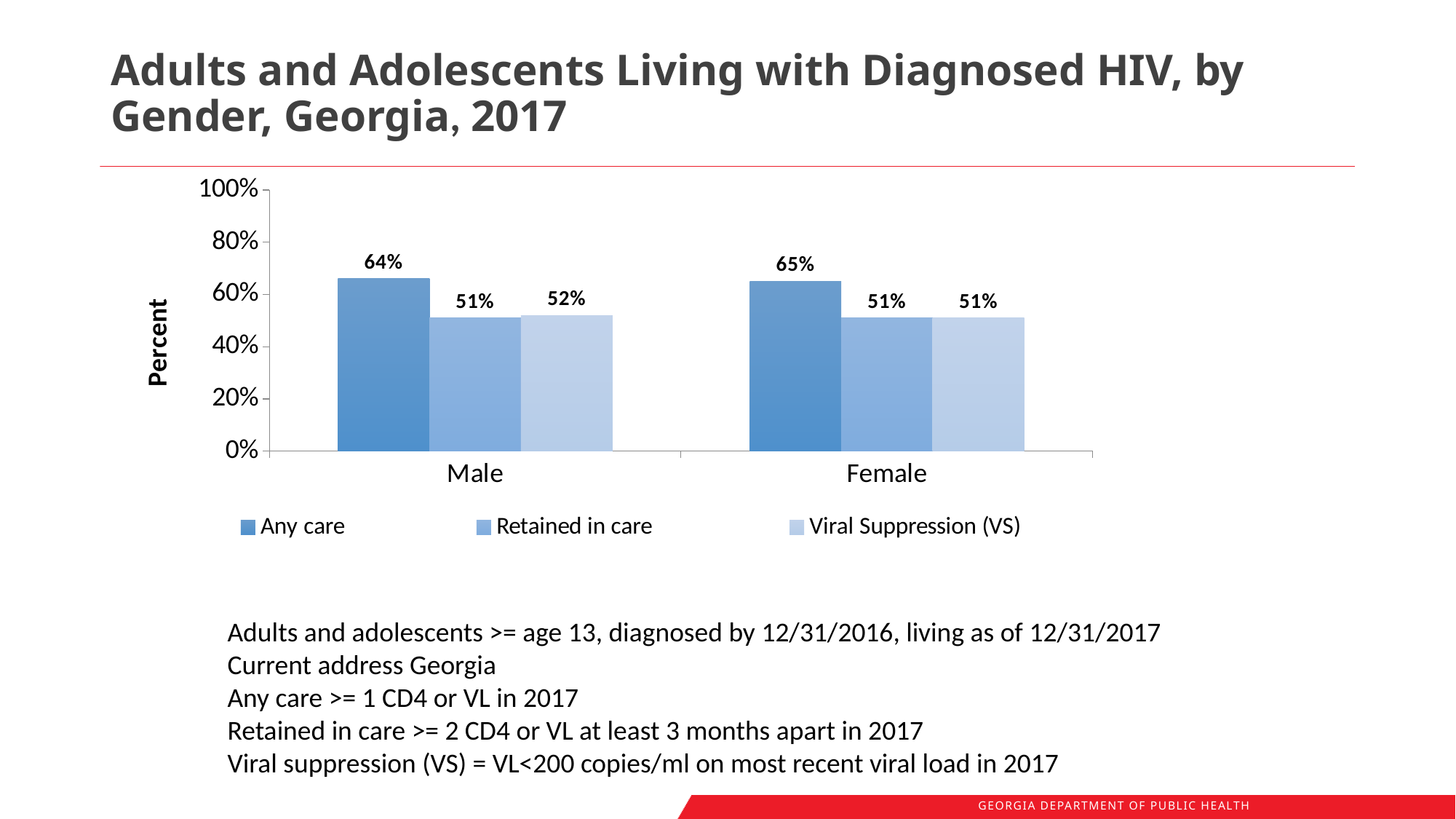
How many series does the legend list? 3 What is the Any care value for Female? 65% What is the Any care value for Male? 64% What is the label of the y axis? Percent What is the Retained in care value for Female? 51% What is the Viral Suppression (VS) value for Male? 52% Which series has the lowest value for Male? Retained in care Which is larger, the Any care value for Male or the Any care value for Female? Female What is the difference between the Any care value for Male and the Retained in care value for Male? 13% How many gender categories are shown on the x axis? 2 What kind of chart is shown on the slide? Bar chart Which series has the highest value for Female? Any care